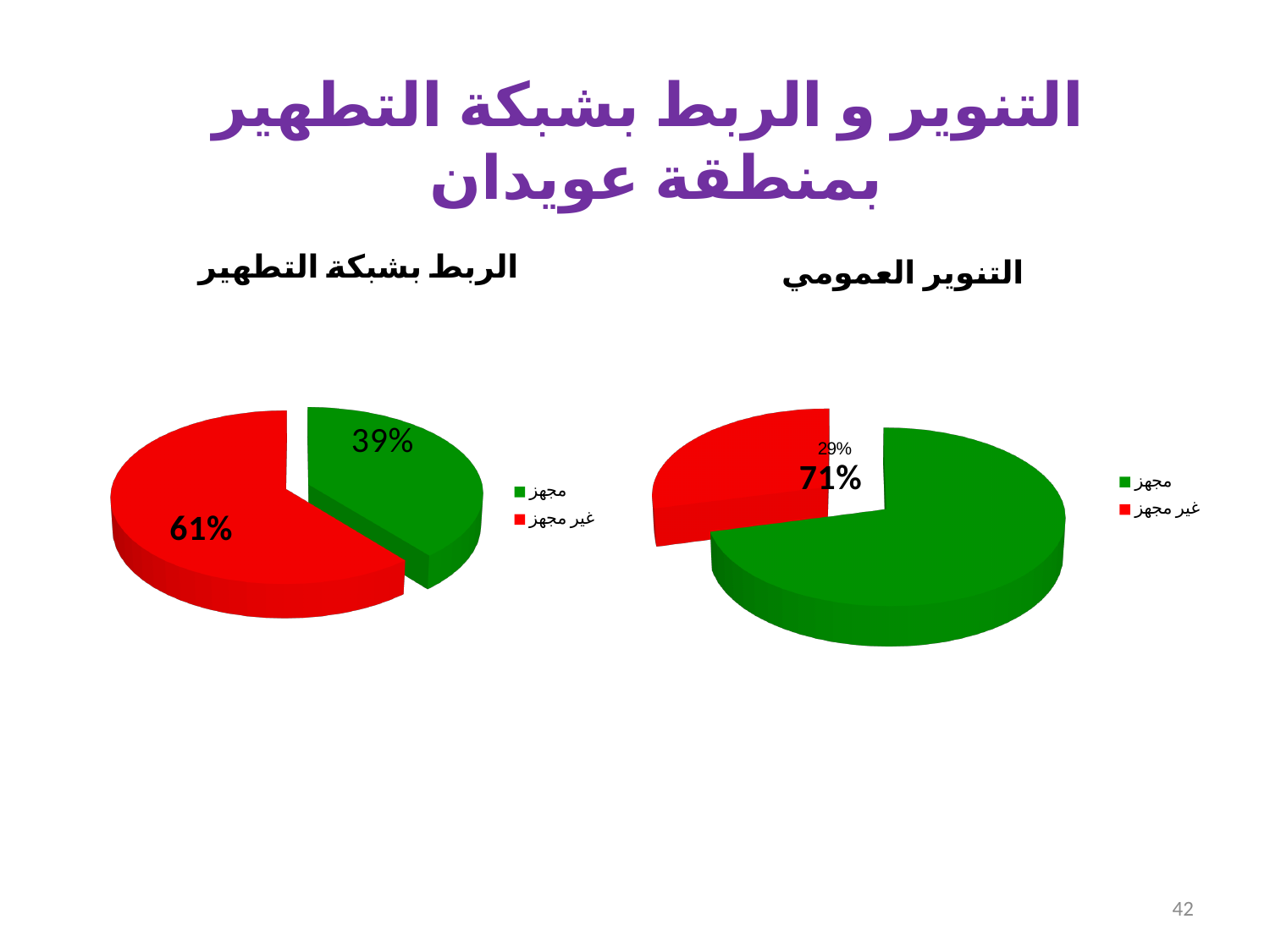
In the chart titled "التنوير العمومي", which category has the largest slice? مجهز In the chart titled "الربط بشبكة التطهير", what is the difference in percentage points between "غير مجهز" and "مجهز"? 22 In the chart titled "الربط بشبكة التطهير", what percentage is shown for "غير مجهز"? 61% How many series does the legend of the chart titled "الربط بشبكة التطهير" list? 2 In the chart titled "الربط بشبكة التطهير", which category has the smallest slice? مجهز In the chart titled "الربط بشبكة التطهير", which is larger, "مجهز" or "غير مجهز"? غير مجهز What type of chart is used for "التنوير العمومي"? Pie chart In the chart titled "التنوير العمومي", what percentage is shown for "غير مجهز"? 29% In the chart titled "التنوير العمومي", what percentage is shown for "مجهز"? 71% In the chart titled "الربط بشبكة التطهير", what percentage is shown for "مجهز"? 39% In the chart titled "التنوير العمومي", what colour is the "غير مجهز" slice? Red In the chart titled "التنوير العمومي", what is the difference in percentage points between "مجهز" and "غير مجهز"? 42